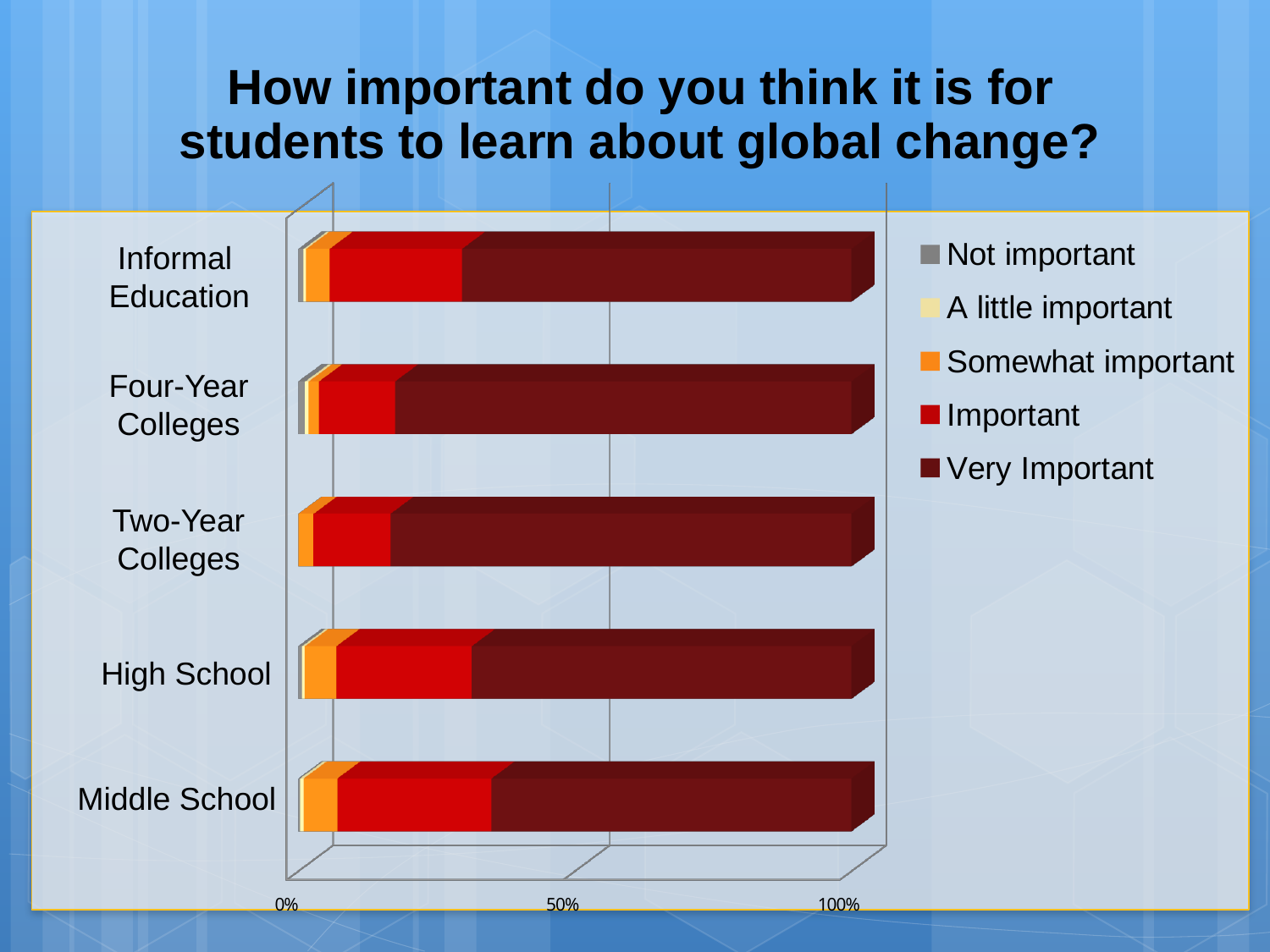
Is the 'Very Important' share for Middle School greater or less than 50%? greater Which legend entry is shown in dark red? Very Important How many categories (education levels) are shown on the chart? 5 What is the title of the chart? How important do you think it is for students to learn about global change? Is the 'Very Important' share for Four-Year Colleges greater or less than 50%? greater Is the 'Important' share for Middle School greater or less than 50%? less Which category is listed at the bottom of the chart? Middle School Which has the larger 'Important' share: Middle School or Four-Year Colleges? Middle School What kind of chart is shown on the slide? Stacked bar chart Which has the larger 'Very Important' share: Four-Year Colleges or Middle School? Four-Year Colleges How many series does the legend list? 5 Which has the larger 'Important' share: Informal Education or Two-Year Colleges? Informal Education